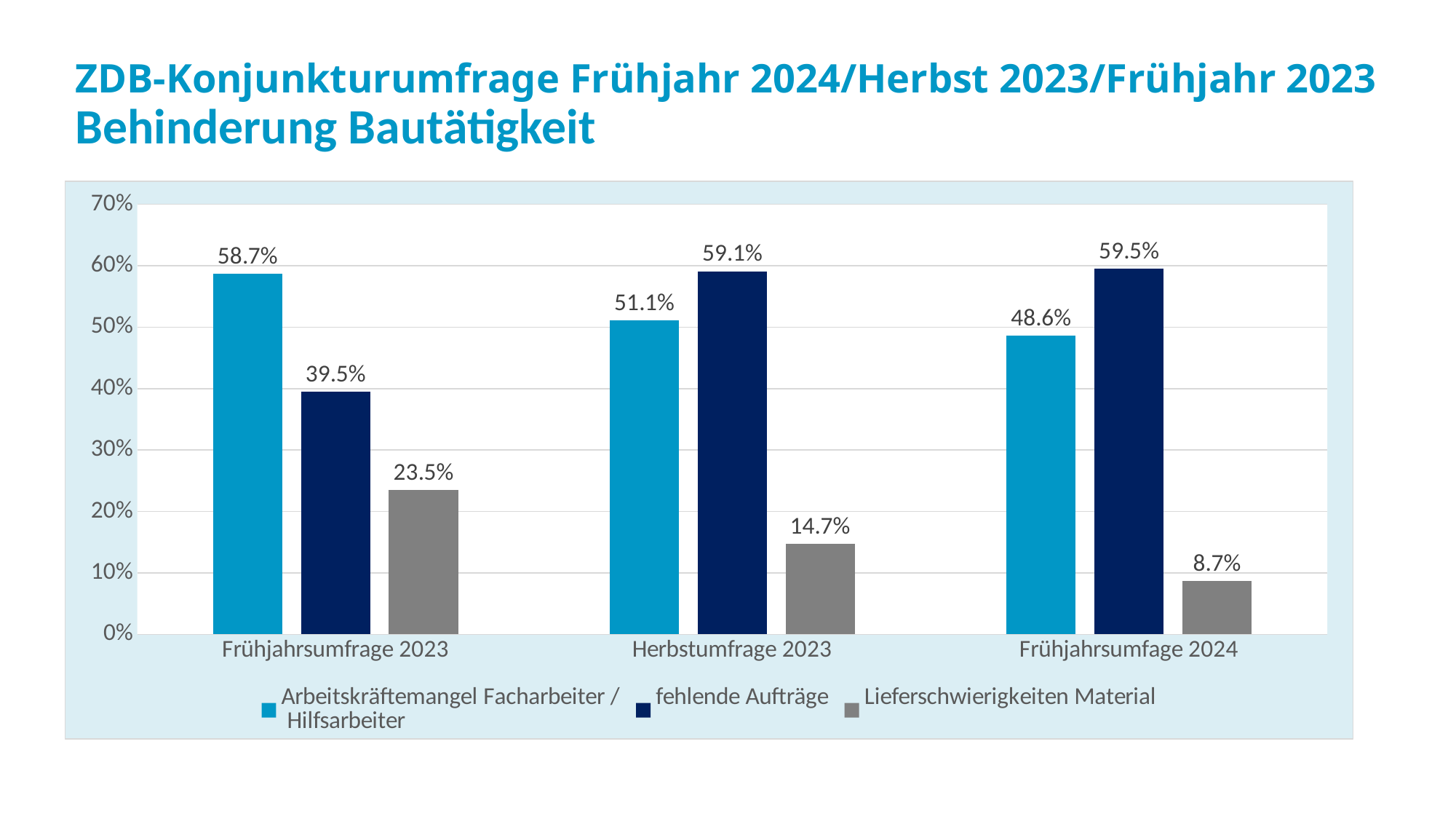
In which survey is the value for 'Arbeitskräftemangel Facharbeiter / Hilfsarbeiter' lowest? Frühjahrsumfage 2024 What is the difference between 'fehlende Aufträge' in Frühjahrsumfage 2024 and in Frühjahrsumfrage 2023? 20.0% How many series does the legend list? 3 How many survey categories are shown on the x axis? 3 What is the value for 'Lieferschwierigkeiten Material' in Frühjahrsumfage 2024? 8.7% What kind of chart is shown on the slide? bar chart What is the value for 'fehlende Aufträge' in Herbstumfrage 2023? 59.1% Which is larger in Herbstumfrage 2023: 'Arbeitskräftemangel Facharbeiter / Hilfsarbeiter' or 'fehlende Aufträge'? fehlende Aufträge Is the value for 'Lieferschwierigkeiten Material' in Herbstumfrage 2023 greater or less than 20%? less In which survey is the value for 'Lieferschwierigkeiten Material' highest? Frühjahrsumfrage 2023 What is the value for 'Arbeitskräftemangel Facharbeiter / Hilfsarbeiter' in Frühjahrsumfrage 2023? 58.7% Does the value for 'Lieferschwierigkeiten Material' rise or fall across the surveys from left to right? fall